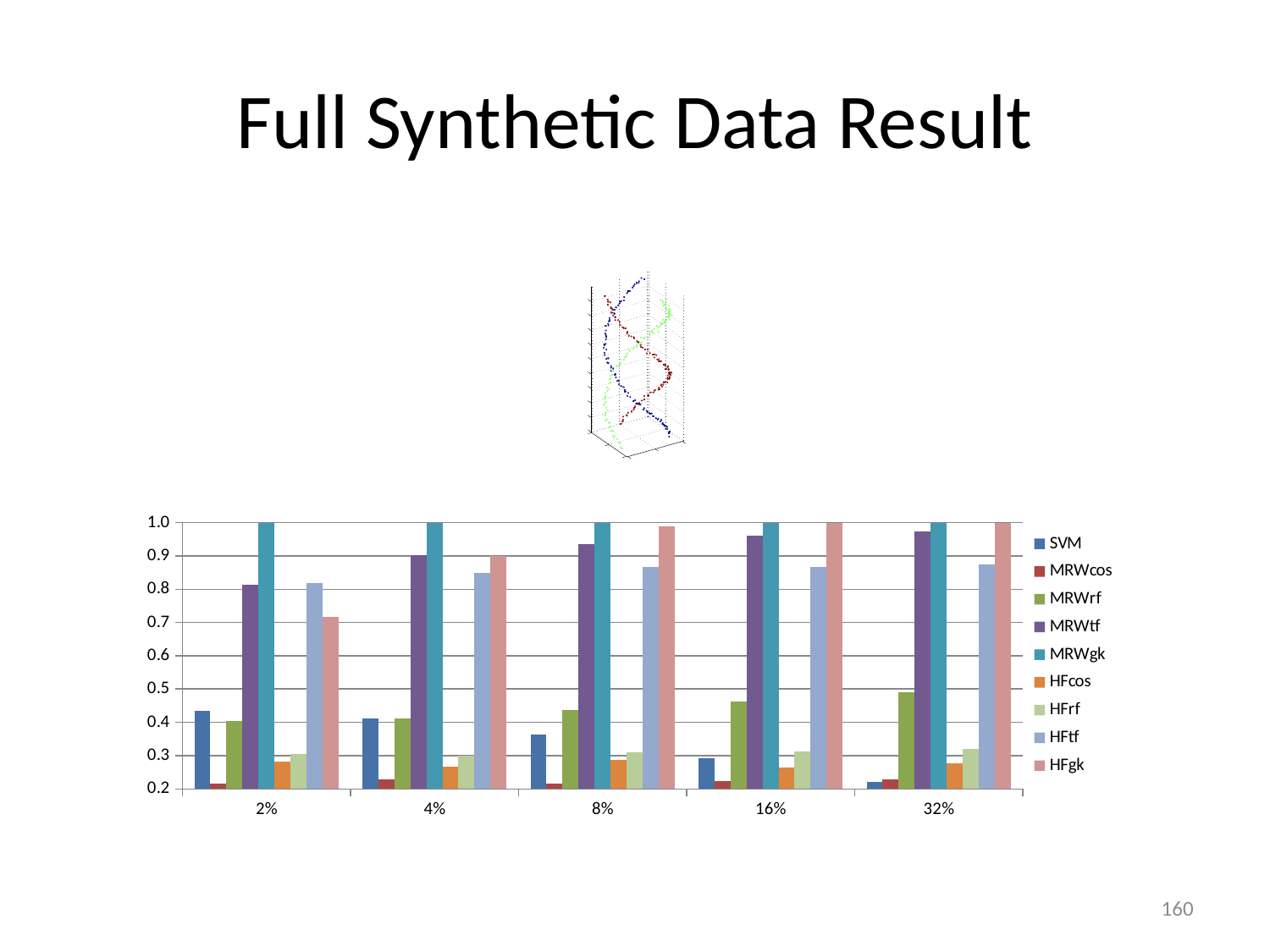
How many categories are shown on the x axis of the bar chart? 5 What kind of chart is shown on the slide? bar chart Which series has the lowest value at the 16% category? MRWcos At the 8% category, which is larger: HFgk or HFtf? HFgk Is the value for MRWtf at 32% greater or less than 0.9? greater At the 2% category, which is larger: HFtf or HFgk? HFtf Is the value for HFcos at 16% greater or less than 0.3? less Is the value for HFtf at 4% greater or less than 0.8? greater Which series has the lowest value at the 2% category? MRWcos How many series does the legend of the bar chart list? 9 Which series has the highest value at the 2% category? MRWgk Do the values for SVM rise or fall as the x axis goes from 2% to 32%? fall